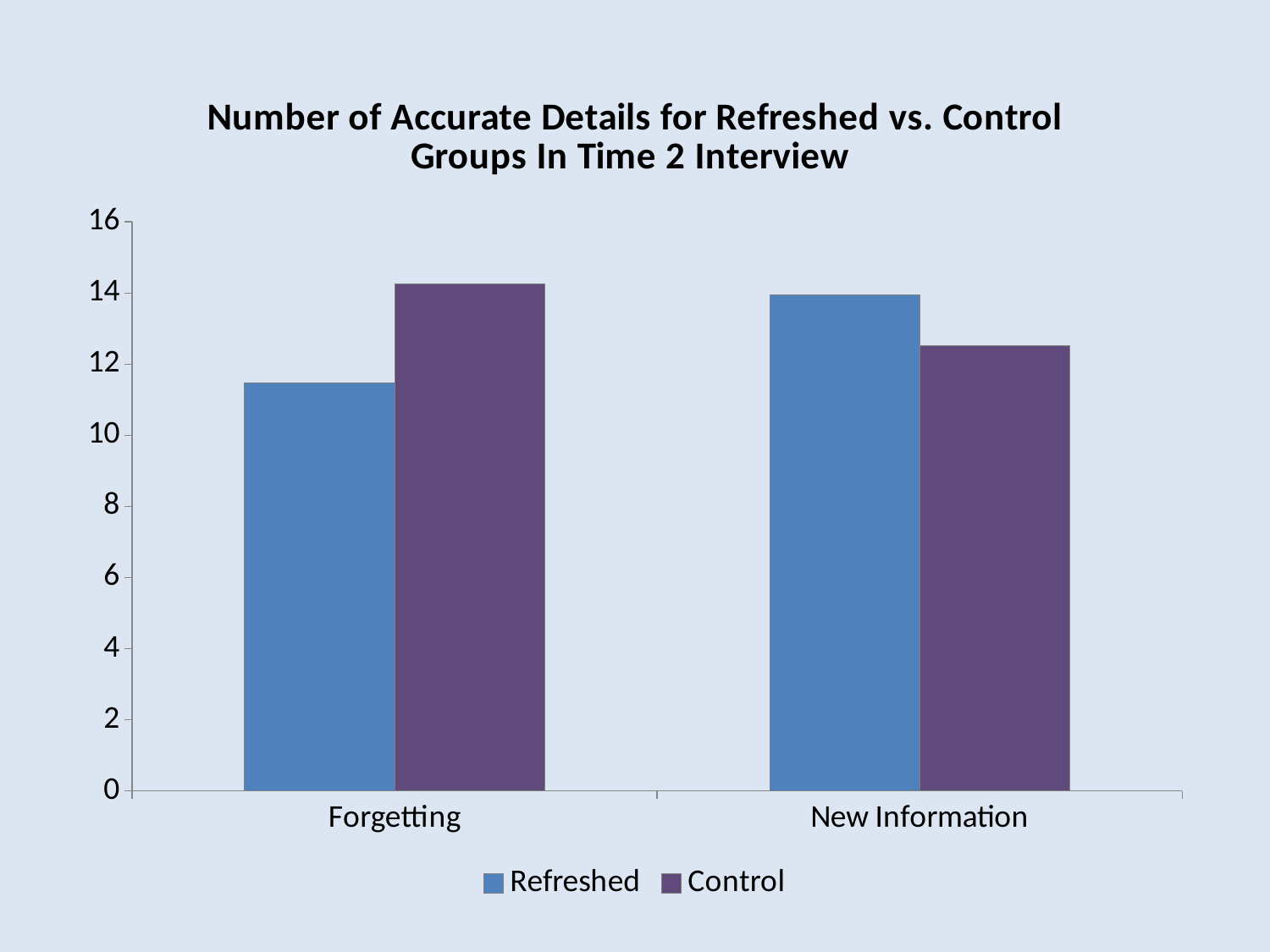
For the New Information category, which group has the larger value, Refreshed or Control? Refreshed Is the value for Refreshed in the Forgetting category greater or less than 12? less How many series does the legend list? 2 Which bar is the lowest on the chart? Refreshed for Forgetting Is the value for Control in the New Information category greater or less than 14? less What is the title of the chart? Number of Accurate Details for Refreshed vs. Control Groups In Time 2 Interview Which bar is the highest on the chart? Control for Forgetting What kind of chart is shown on the slide? bar chart Is the value for Control in the Forgetting category greater or less than 14? greater Which series is shown in blue? Refreshed For the Forgetting category, which group has the larger value, Refreshed or Control? Control How many categories are shown on the x axis? 2